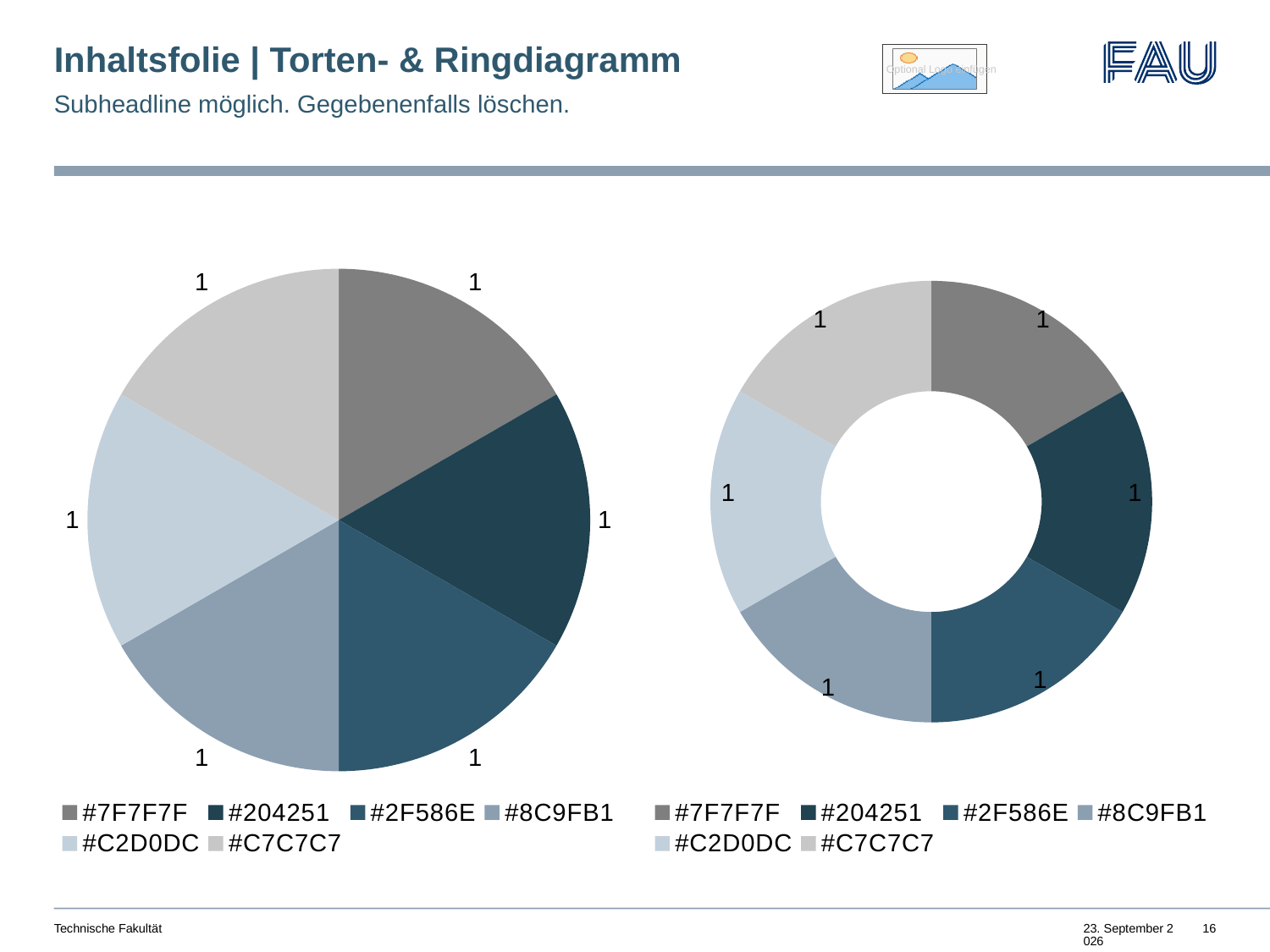
In the pie chart on the left, what is the total of all slice values? 6 In the doughnut chart on the right, what is the total of all segment values? 6 In the pie chart on the left, what is the value for #204251? 1 In the pie chart on the left, which legend entry is shown in the darkest colour? #204251 What kind of chart is the chart on the right of the slide? doughnut chart In the pie chart on the left, how many slices are there? 6 In the doughnut chart on the right, what is the value for #C2D0DC? 1 What kind of chart is the chart on the left of the slide? pie chart In the pie chart on the left, what is the value for #C7C7C7? 1 How many entries does the legend of the doughnut chart on the right list? 6 In the pie chart on the left, is the value for #7F7F7F larger than, smaller than, or equal to the value for #8C9FB1? equal In the doughnut chart on the right, how many segments are there? 6